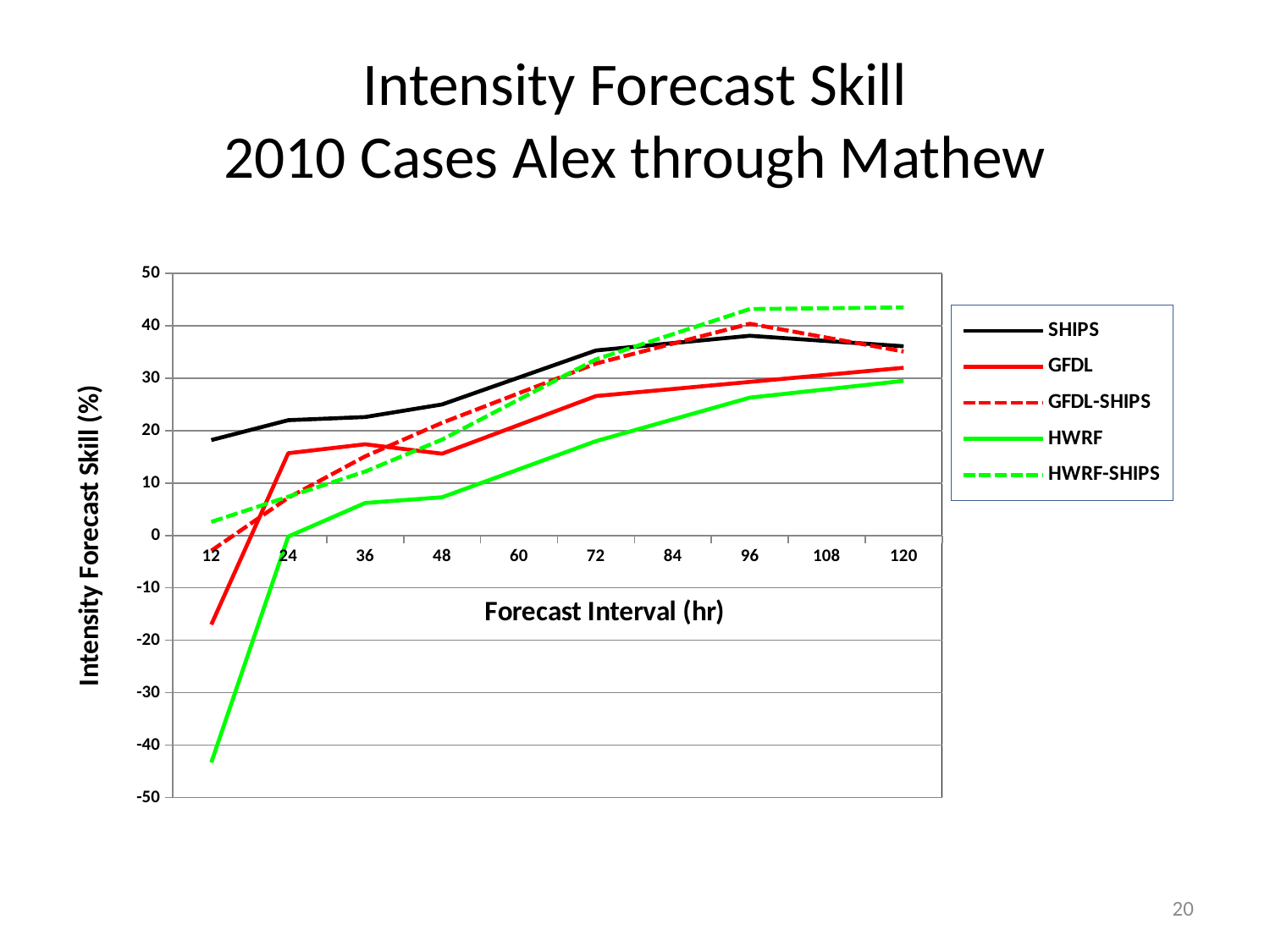
At the 48 hr forecast interval, which is larger: SHIPS or HWRF? SHIPS Is the value for GFDL at 12 hr greater or less than -10? less What kind of chart is shown on the slide? line chart How many series does the legend list? 5 How many forecast intervals are plotted along the x axis? 10 Is the value for HWRF at 12 hr greater or less than -40? less Which series has the lowest intensity forecast skill at the 12 hr forecast interval? HWRF Which series has the highest intensity forecast skill at the 120 hr forecast interval? HWRF-SHIPS What is the title of the x axis? Forecast Interval (hr) Is the value for SHIPS at 12 hr greater or less than 10? greater At the 12 hr forecast interval, which is larger: SHIPS or GFDL? SHIPS Does the HWRF series rise or fall as the forecast interval increases from 12 to 120 hr? rises